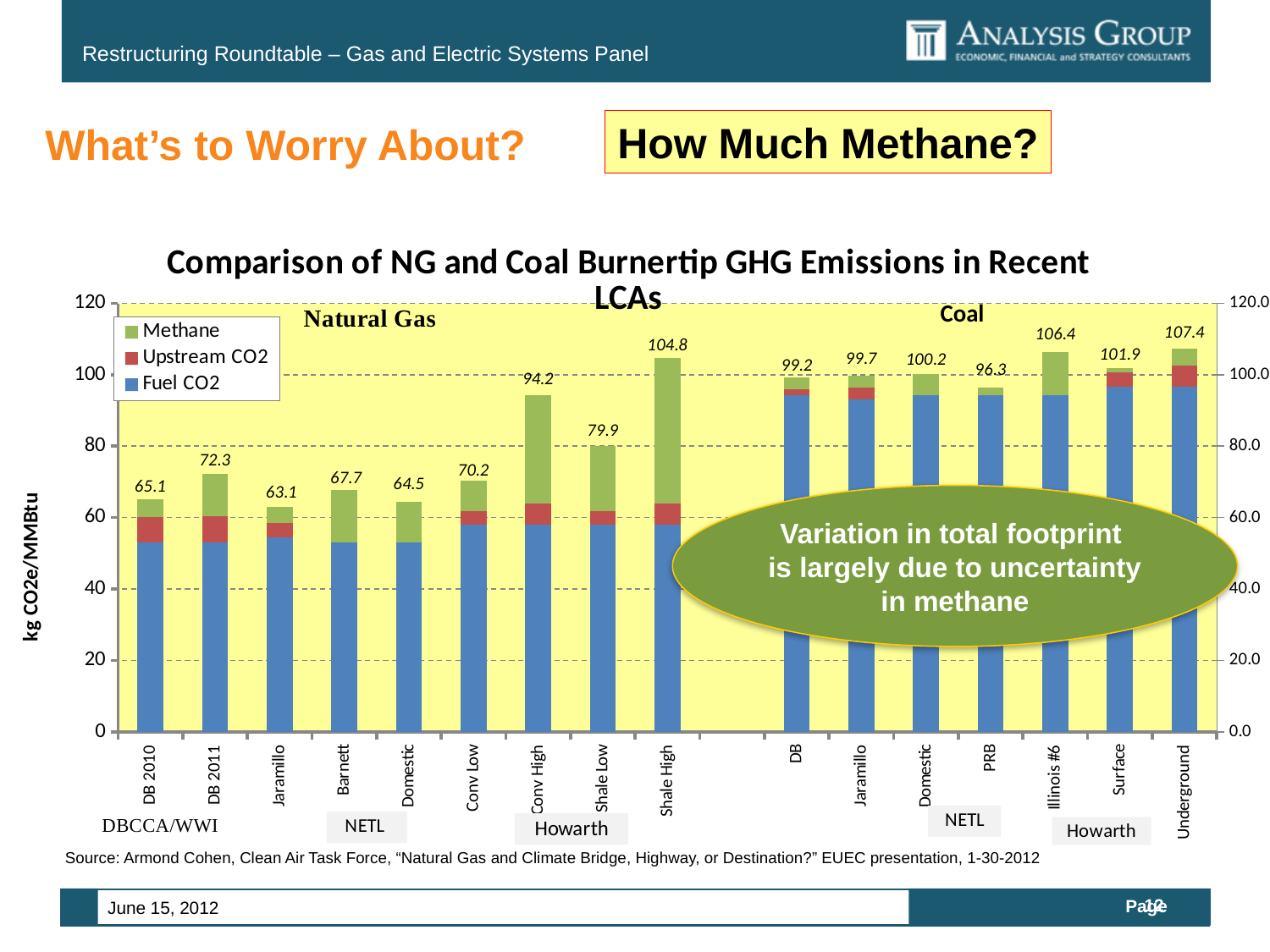
What is the difference between the Conv High and Conv Low totals? 24.0 What is the difference between the Shale High and Shale Low totals? 24.9 How many bars are plotted in the chart? 16 What is the total labeled on the Shale High bar in the Natural Gas group? 104.8 Which bar has the highest total kg CO2e/MMBtu? Underground (Coal) Is the Fuel CO2 value for DB 2010 greater or less than 60? less Which bar has the lowest total kg CO2e/MMBtu? Jaramillo (Natural Gas) How many series does the legend list? 3 What is the total labeled on the Underground bar in the Coal group? 107.4 What is the total labeled on the PRB bar in the Coal group? 96.3 What kind of chart is shown on the slide? Stacked bar chart Which has a larger total, DB 2010 or DB 2011? DB 2011